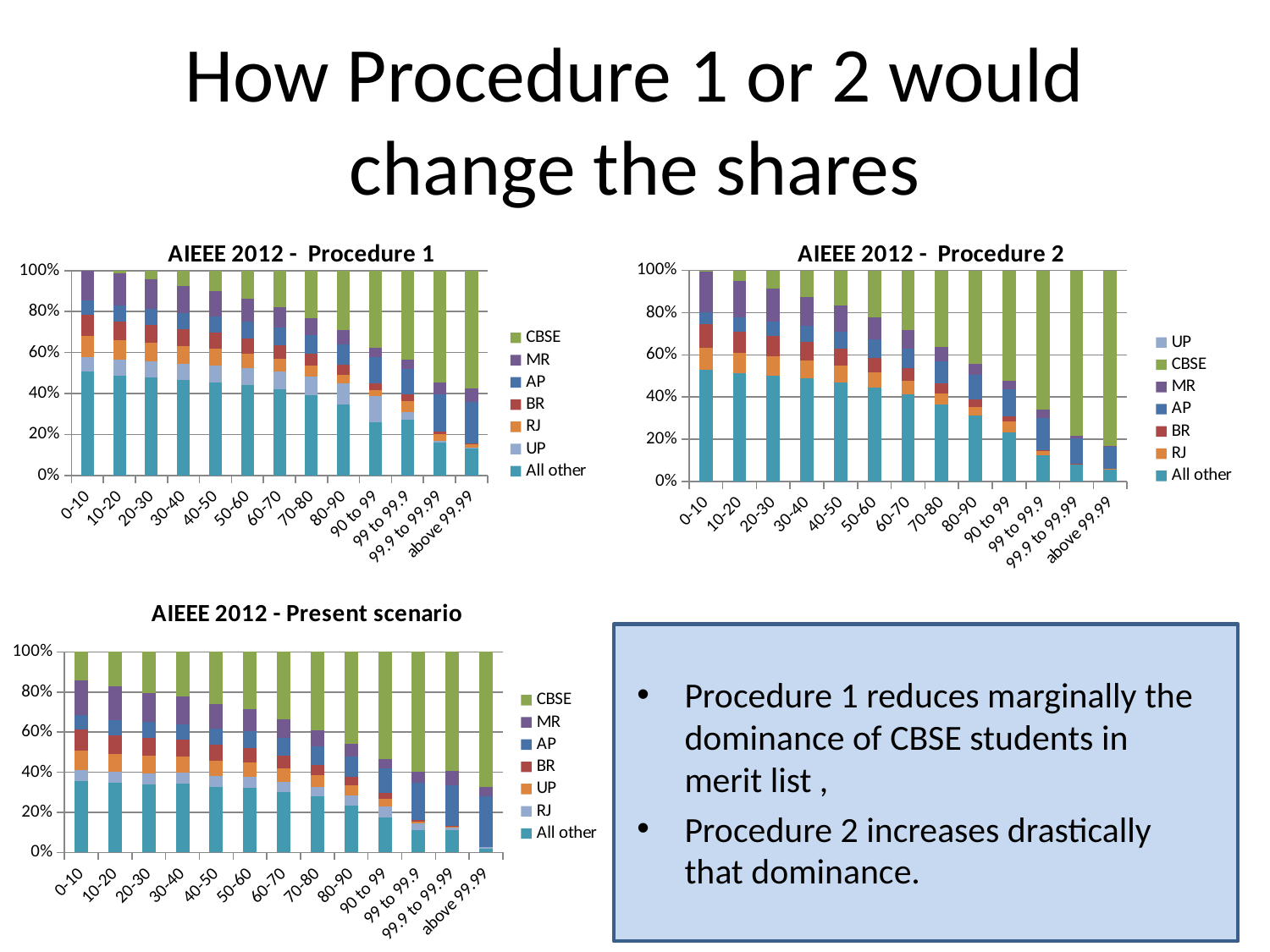
In the "AIEEE 2012 - Procedure 2" chart, does the "All other" share rise or fall as you move from 0-10 to "above 99.99" along the x axis? fall What does each stacked bar in the "AIEEE 2012 - Present scenario" chart total? 100% In the "AIEEE 2012 - Procedure 1" chart, which category has the larger "All other" share: 0-10 or "above 99.99"? 0-10 In the "AIEEE 2012 - Present scenario" chart, is the "All other" share for the 0-10 category greater or less than 40%? less What kind of chart is the "AIEEE 2012 - Procedure 1" chart? Stacked bar chart How many series does the legend of the "AIEEE 2012 - Procedure 2" chart list? 7 In the "AIEEE 2012 - Procedure 2" chart, is the "All other" share for the 0-10 category greater or less than 40%? greater In the "AIEEE 2012 - Present scenario" chart, is the "All other" share for the "above 99.99" category greater or less than 20%? less Which series is listed first in the legend of the "AIEEE 2012 - Procedure 2" chart? UP How many score-range categories are shown on the x axis of the "AIEEE 2012 - Present scenario" chart? 13